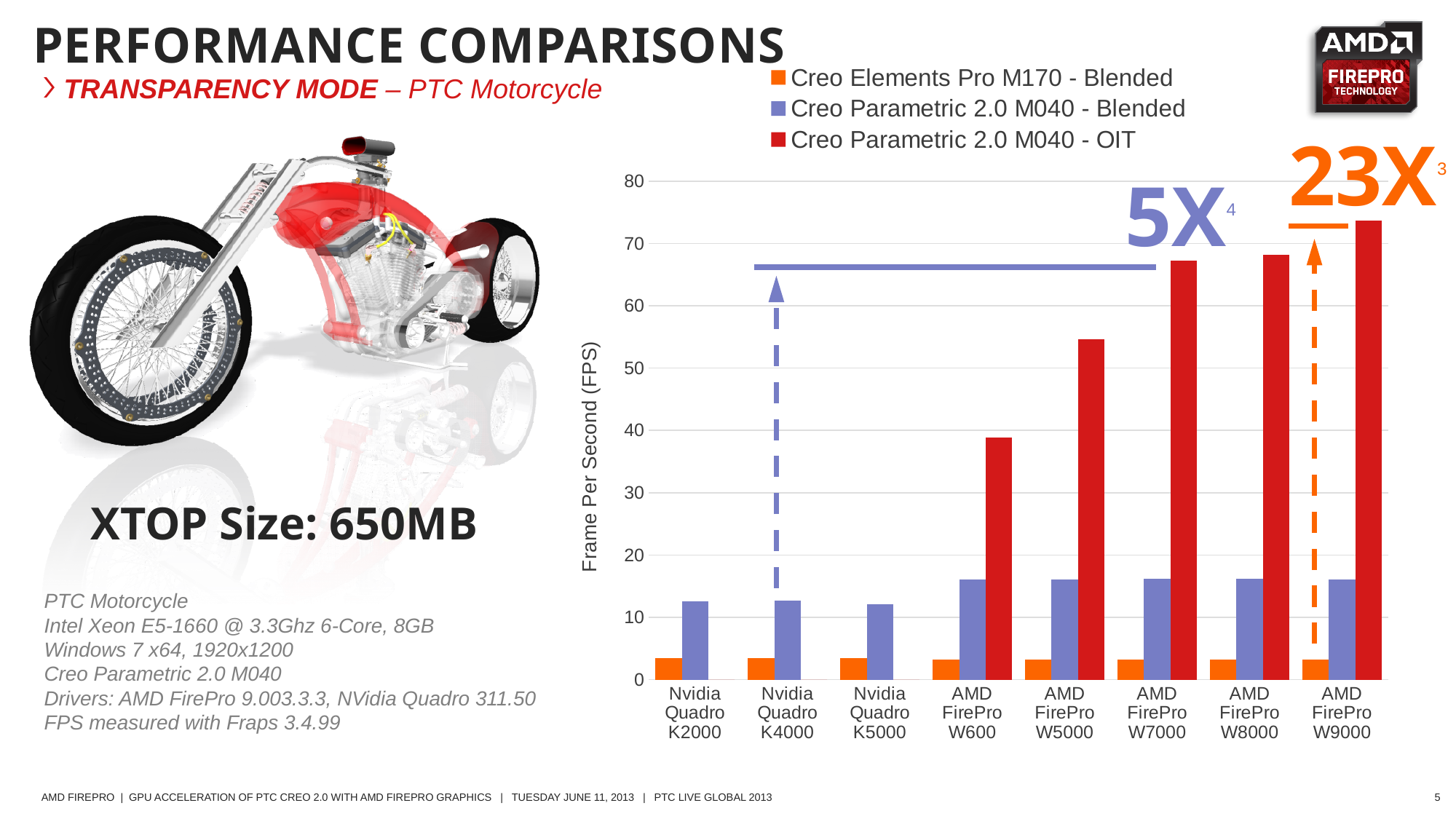
How many graphics cards (categories) are shown on the x axis of the chart? 8 Do the Creo Parametric 2.0 M040 - OIT values rise or fall from AMD FirePro W600 to AMD FirePro W9000? rise Which series in the legend is shown in orange? Creo Elements Pro M170 - Blended What is the label on the chart's vertical axis? Frame Per Second (FPS) Which graphics card has the highest Creo Parametric 2.0 M040 - OIT value? AMD FirePro W9000 What kind of chart is shown on the slide? bar chart Is the Creo Parametric 2.0 M040 - OIT value for AMD FirePro W5000 greater or less than 50? greater Is the Creo Parametric 2.0 M040 - Blended value for Nvidia Quadro K5000 greater or less than 20? less Is the Creo Parametric 2.0 M040 - OIT value for AMD FirePro W9000 greater or less than 70? greater Which is larger for AMD FirePro W7000: the Creo Parametric 2.0 M040 - OIT value or the Creo Parametric 2.0 M040 - Blended value? Creo Parametric 2.0 M040 - OIT How many series does the chart's legend list? 3